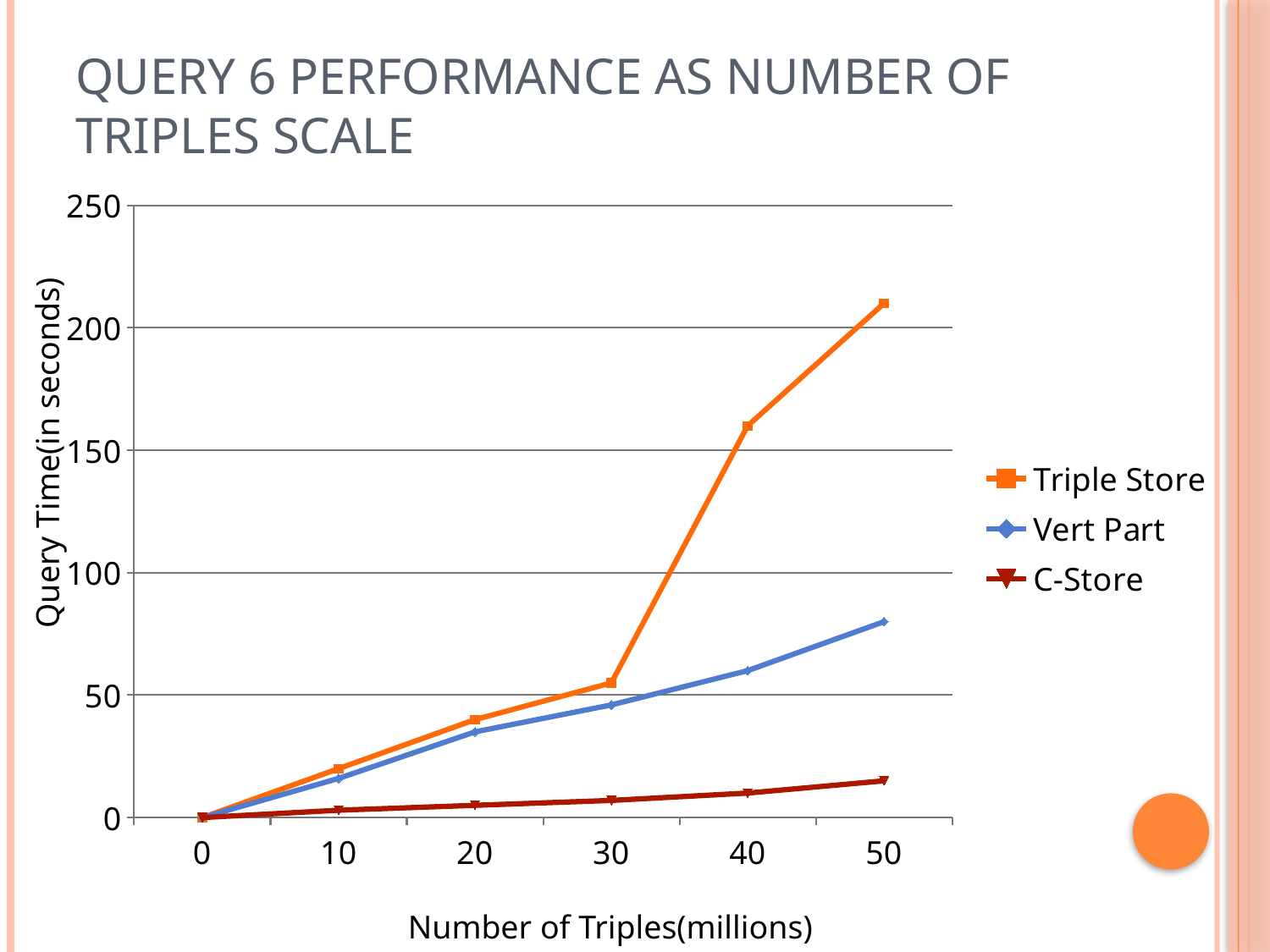
Is the Vert Part query time at 50 million triples greater or less than 100 seconds? less What kind of chart is shown on the slide? Line chart Is the C-Store query time at 50 million triples greater or less than 50 seconds? less Is the Triple Store query time at 40 million triples greater or less than 150 seconds? greater How many data points are plotted for the Triple Store series? 6 How many series does the legend list? 3 What is the label of the y axis? Query Time(in seconds) Which series has the highest query time at 50 million triples? Triple Store Which series has the lowest query time at 50 million triples? C-Store At 40 million triples, which has the larger query time, Vert Part or C-Store? Vert Part Does the Triple Store query time rise or fall as the number of triples increases? Rises